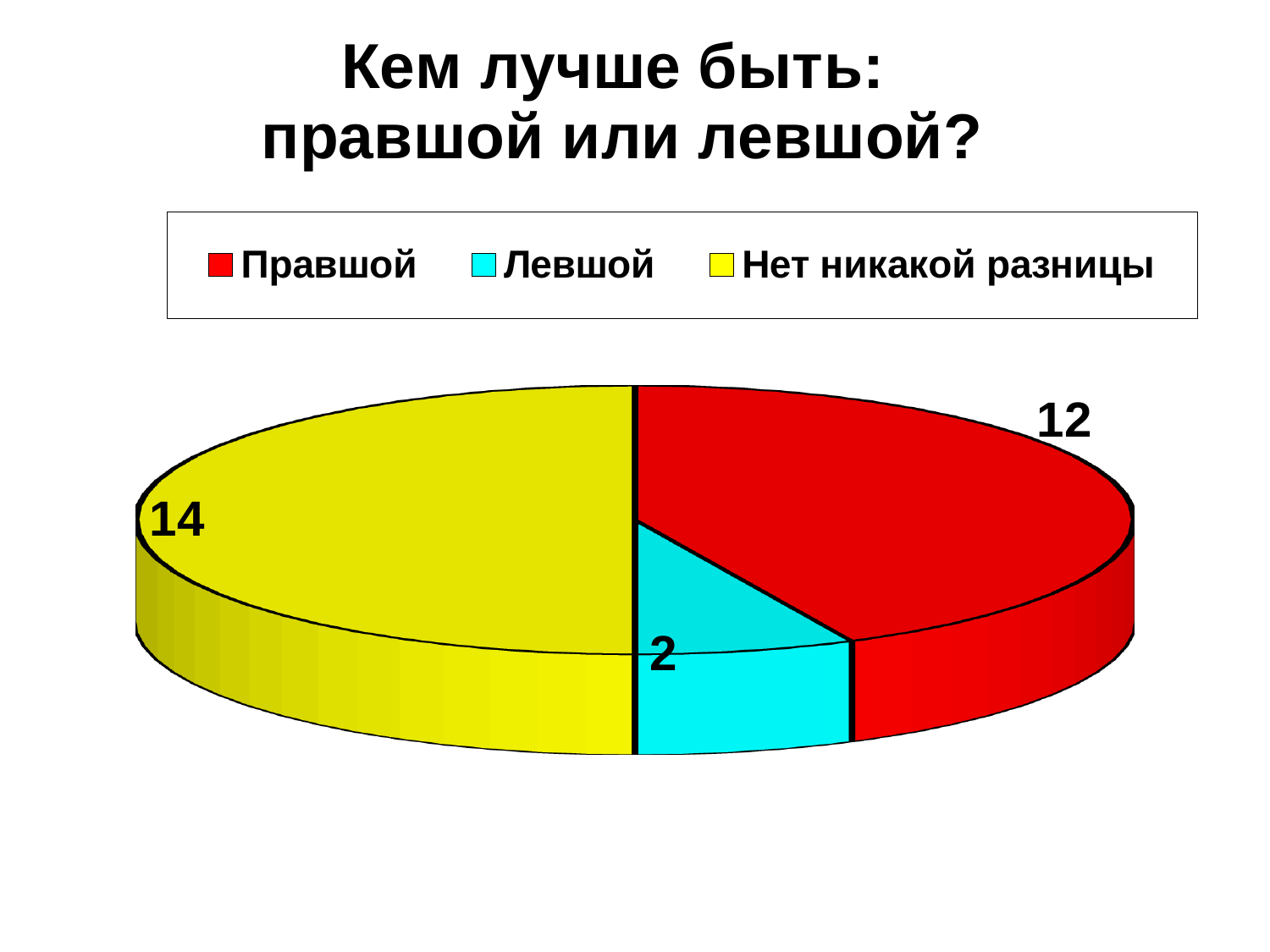
What is the value for Левшой? 2 Which category has the largest slice? Нет никакой разницы What is the value for Нет никакой разницы? 14 What is the value for Правшой? 12 What is the difference between the values for Нет никакой разницы and Правшой? 2 What is the difference between the values for Правшой and Левшой? 10 Which is larger, the value for Правшой or the value for Левшой? Правшой What kind of chart is shown on the slide? Pie chart What share of the pie does the Нет никакой разницы slice represent? 50% What colour is the Левшой slice? Cyan Which category has the smallest slice? Левшой How many slices does the pie chart have? 3